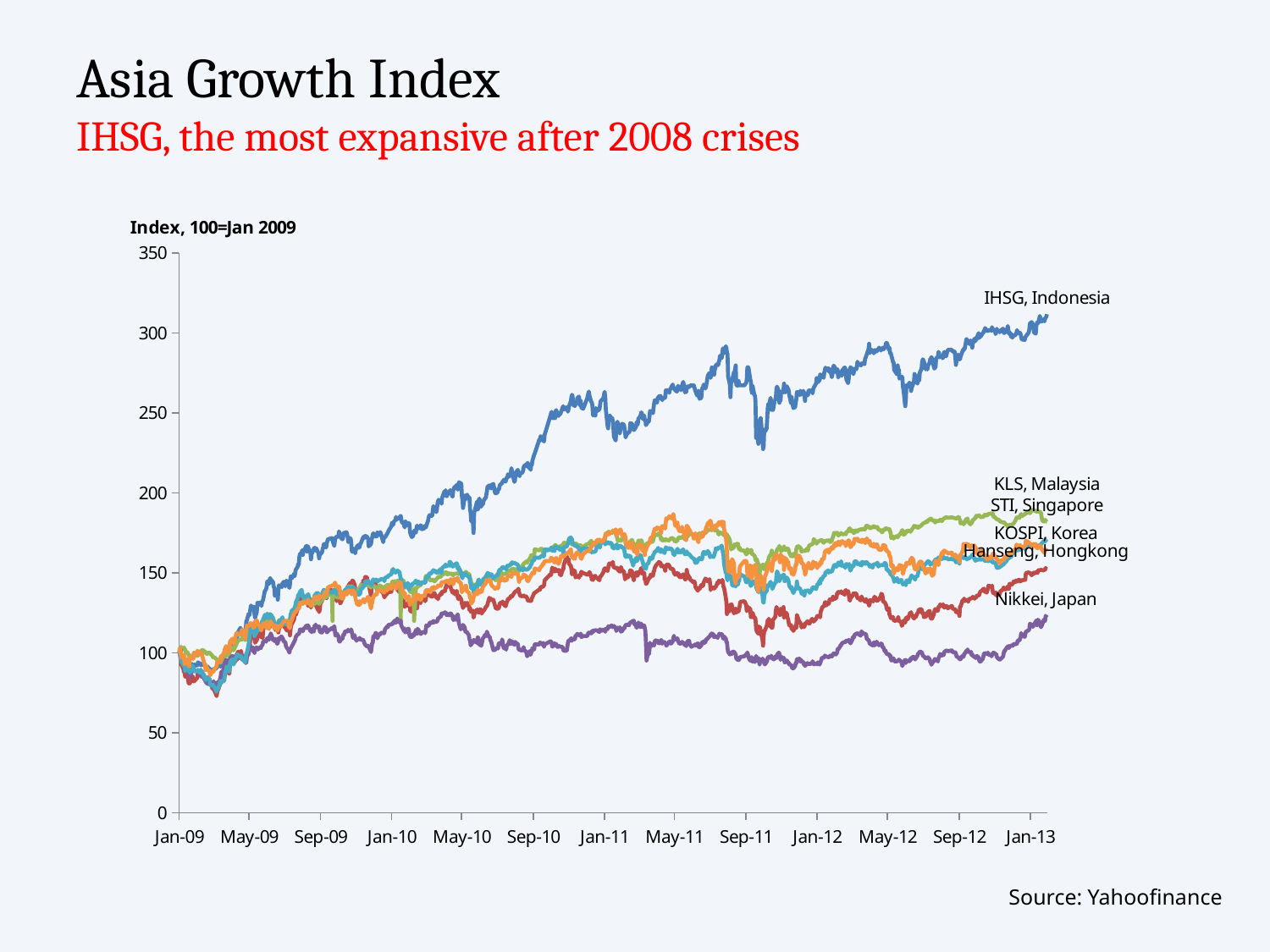
Is the value for IHSG, Indonesia at Jan-13 greater or less than 300? greater Is the value for IHSG, Indonesia at Jan-12 greater or less than 250? greater Which is larger at Jan-13, the value for IHSG, Indonesia or the value for Nikkei, Japan? IHSG, Indonesia What is the base of the index according to the axis label above the chart? 100=Jan 2009 Which index has the lowest value at the end of the period (Jan-13)? Nikkei, Japan How many index series are plotted on the chart? 6 What kind of chart is shown on the slide? line chart Is the value for KLS, Malaysia at Jan-13 greater or less than 150? greater How many date labels are shown on the x axis? 13 Which index has the highest value at the end of the period (Jan-13)? IHSG, Indonesia Does the IHSG, Indonesia line generally rise or fall from Jan-09 to Jan-13? rise